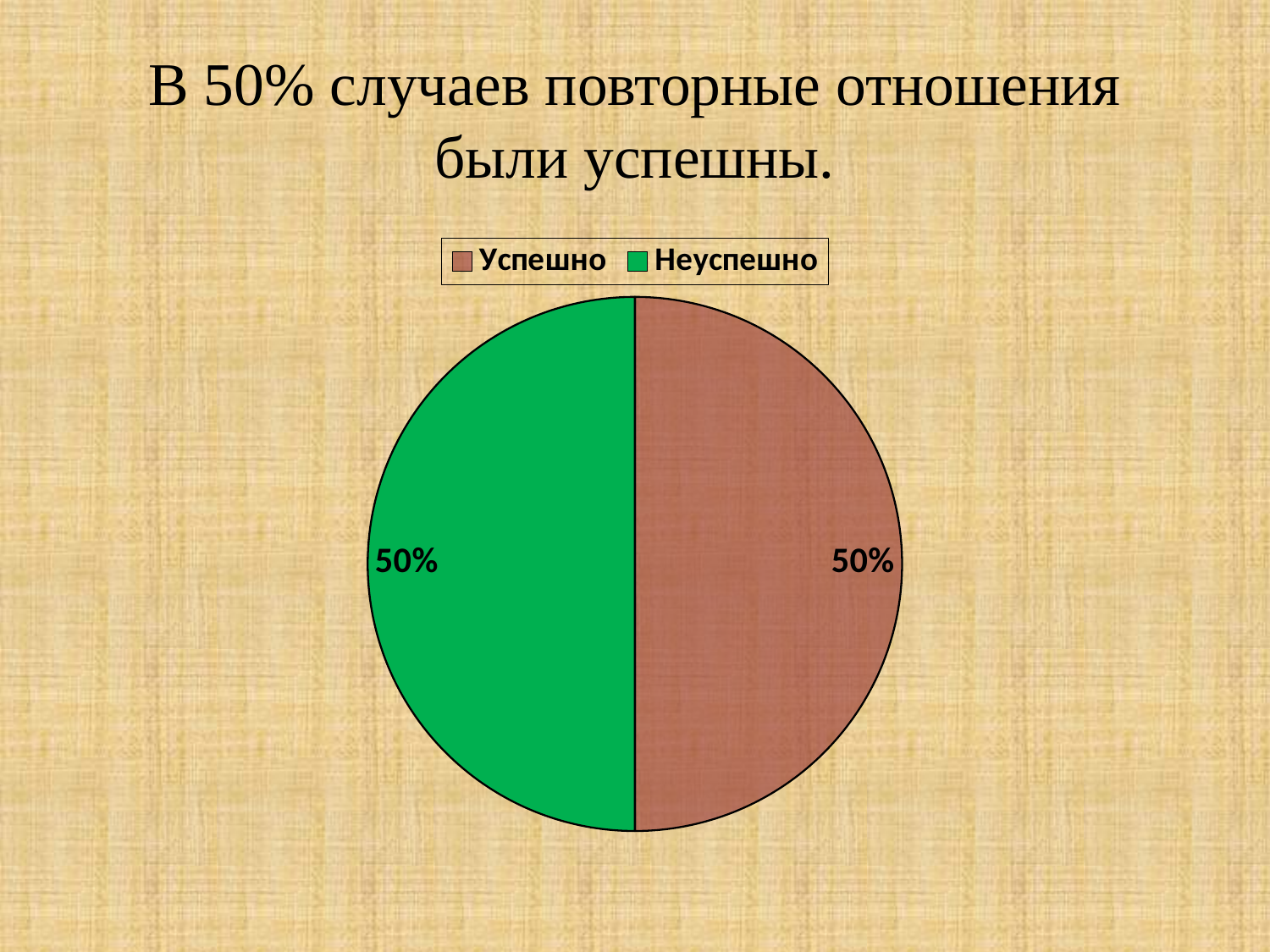
What is the difference between the Успешно and Неуспешно shares? 0% What share of the pie does Неуспешно take? 50% Which colour represents Успешно in the pie chart? brown How many slices does the pie chart have? 2 What is the total of the two slices shown? 100% What kind of chart is shown on the slide? pie chart What share of the pie does Успешно take? 50% Which colour represents Неуспешно in the pie chart? green How many entries does the legend list? 2